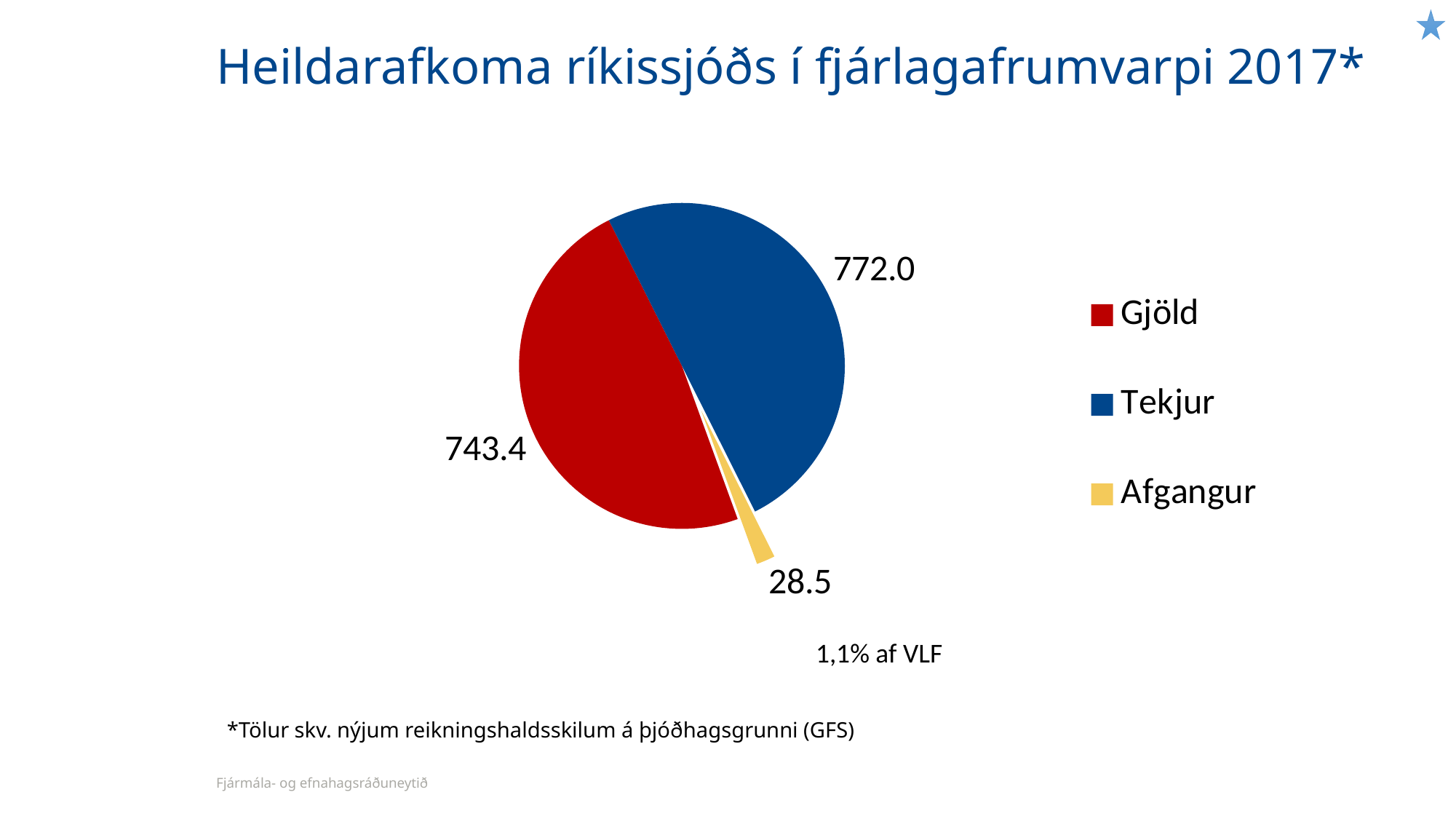
What is the title of the chart on the slide? Heildarafkoma ríkissjóðs í fjárlagafrumvarpi 2017* What is the value for Afgangur? 28.5 What is the value for Gjöld? 743.4 What colour is the Afgangur slice in the pie chart? yellow What is the difference between the values for Gjöld and Afgangur? 714.9 What type of chart is shown on the slide? pie chart What is the difference between the values for Tekjur and Gjöld? 28.6 Which category has the largest slice of the pie? Tekjur Which is larger, the value for Gjöld or the value for Tekjur? Tekjur What is the value for Tekjur? 772.0 How many slices does the pie chart have? 3 Which category has the smallest slice of the pie? Afgangur